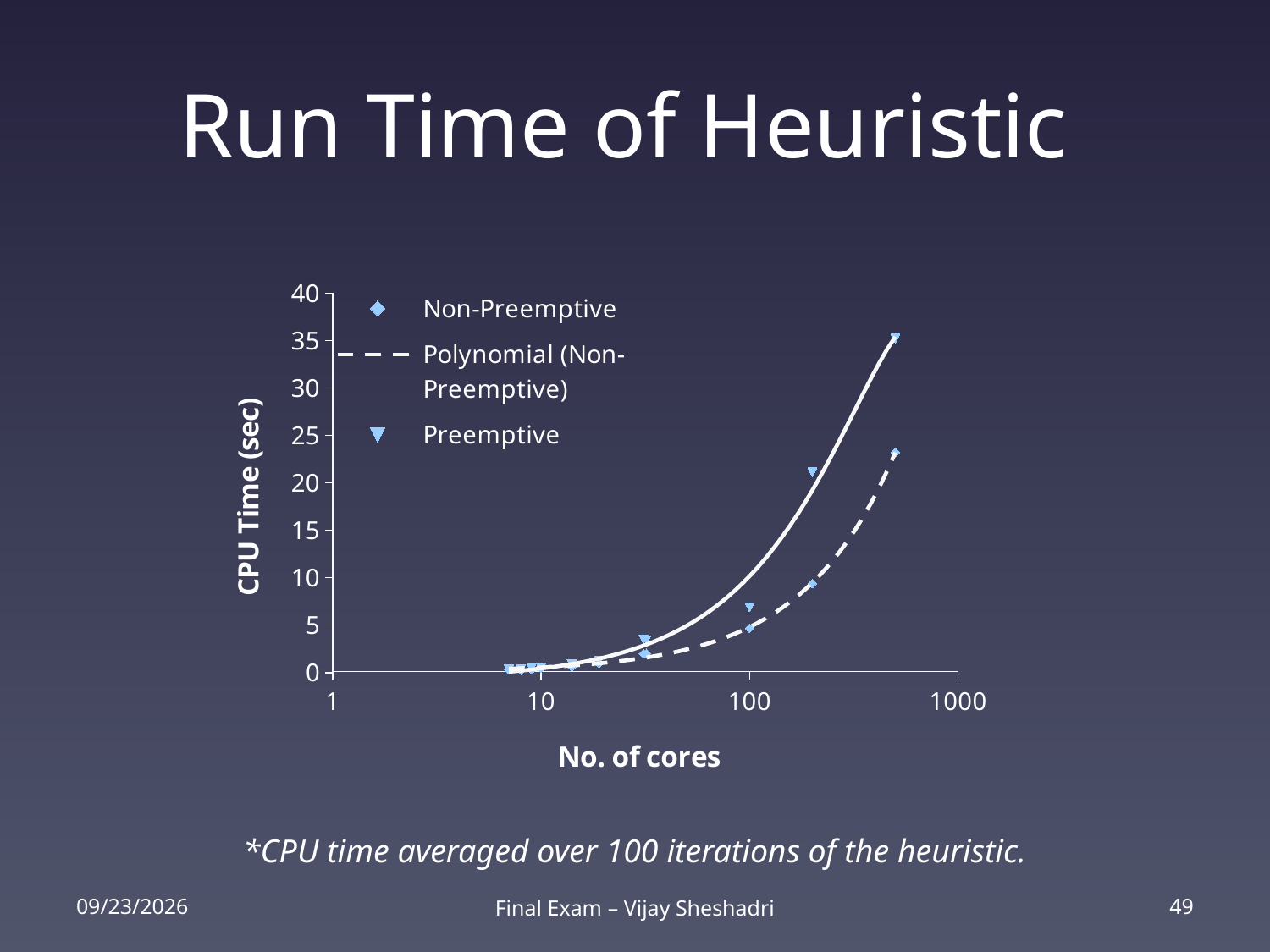
Does CPU time rise or fall as the number of cores increases? rise Is the Preemptive CPU time at the highest number of cores plotted greater or less than 30 seconds? greater What is the title of the chart's x axis? No. of cores How many entries does the chart legend list? 3 Is the Preemptive CPU time at 100 cores greater or less than 5 seconds? greater Is the Preemptive CPU time at 100 cores greater or less than 10 seconds? less What is the title of the chart's y axis? CPU Time (sec) At the highest number of cores plotted, which series has the larger CPU time, Preemptive or Non-Preemptive? Preemptive What is the highest value shown on the y axis? 40 What kind of chart is shown on the slide? scatter chart